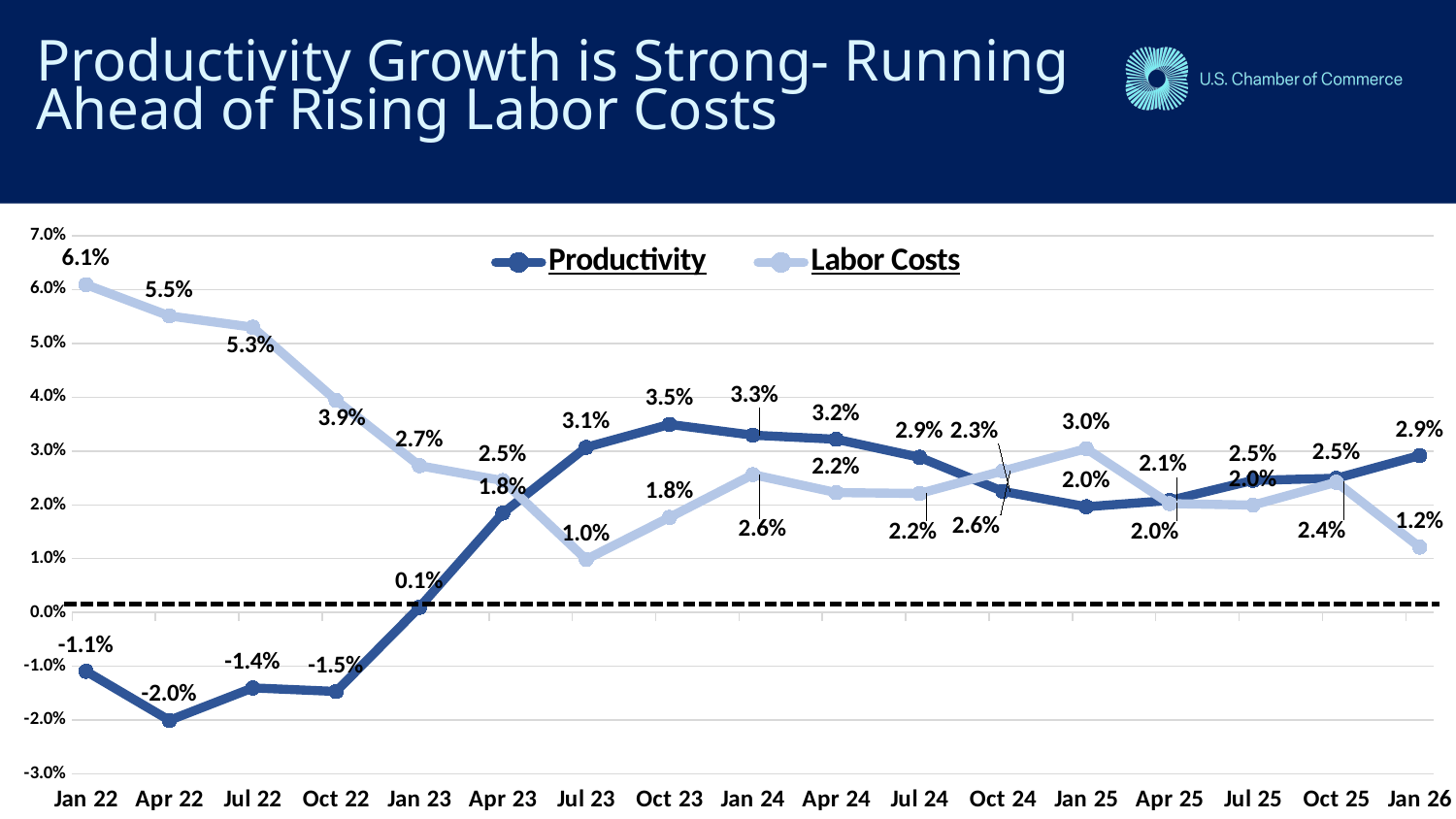
What is the Productivity value for Apr 22? -2.0% What is the Productivity value for Oct 23? 3.5% What is the Labor Costs value for Jan 26? 1.2% In which period is Labor Costs at its lowest? Jul 23 Does the Labor Costs series rise or fall from Jan 22 to Jul 23? Fall In which period is Productivity at its highest? Oct 23 Which is larger in Jan 26, Productivity or Labor Costs? Productivity What is the difference between Labor Costs and Productivity in Jan 22? 7.2 percentage points How many time periods are shown on the x axis? 17 How many series does the legend list? 2 What is the Labor Costs value for Jan 22? 6.1% What type of chart is shown on the slide? Line chart